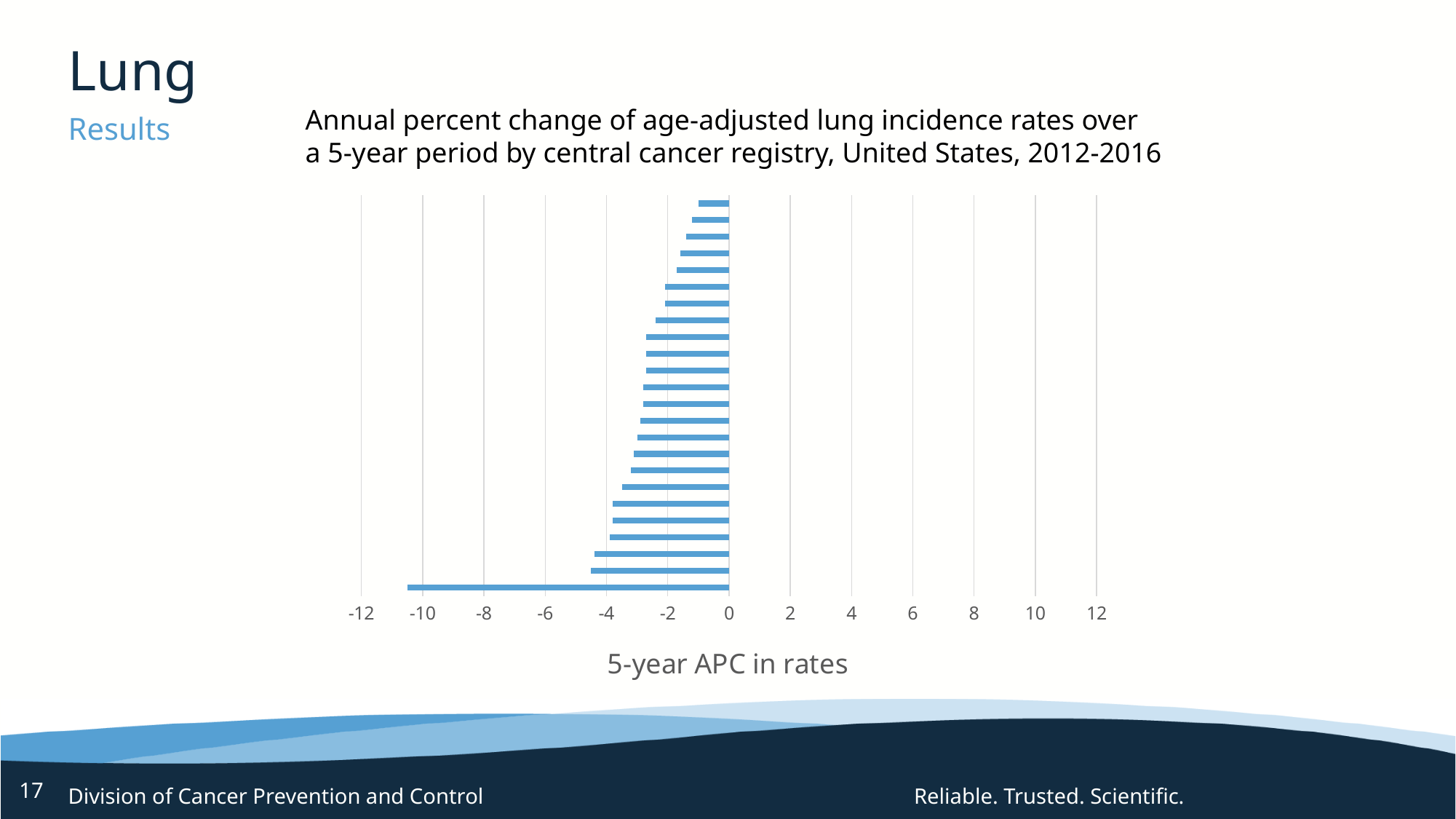
Is the value of the second bar from the bottom greater or less than -4? less Is the value of the longest (bottom) bar greater or less than -10? less How many bars are plotted in the chart? 24 Is the value of the shortest (top) bar greater or less than -2? greater What is the title of the chart? Annual percent change of age-adjusted lung incidence rates over a 5-year period by central cancer registry, United States, 2012-2016 What is the lowest value shown on the horizontal axis? -12 Which bar has the lowest value, the top bar or the bottom bar? the bottom bar Do the bars get longer or shorter moving from the top of the chart to the bottom? longer Are the plotted values positive or negative? negative What is the label of the horizontal axis? 5-year APC in rates Which is larger, the value of the top bar or the value of the bottom bar? the top bar What kind of chart is shown on the slide? bar chart